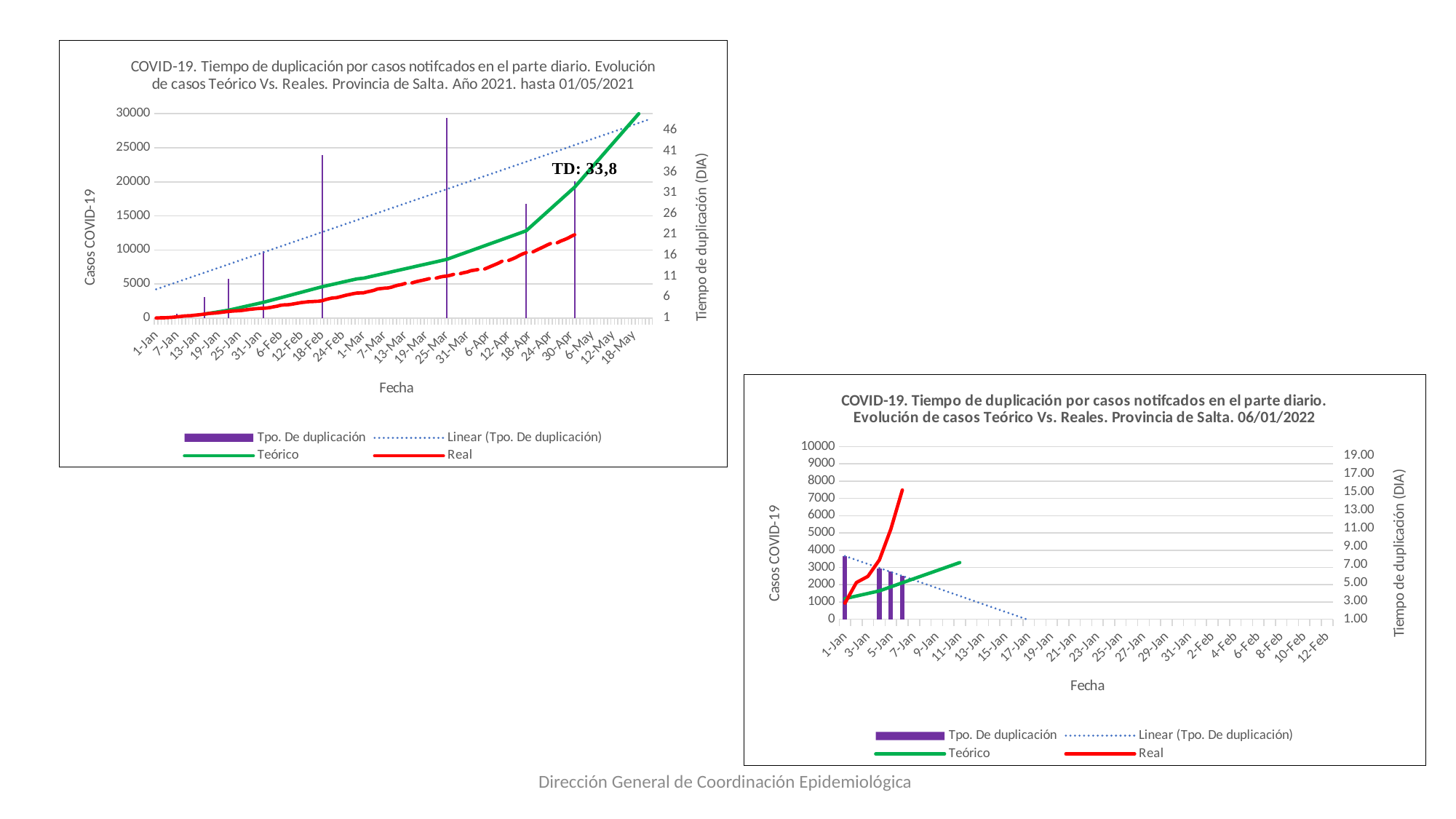
On the left chart (Año 2021, hasta 01/05/2021), on which date is the tallest Tpo. De duplicación bar? 25-Mar On the left chart (Año 2021, hasta 01/05/2021), is the Real value at 30-Apr greater or less than 15000? less On the left chart (Año 2021, hasta 01/05/2021), what kind of chart is it? Combined bar and line chart On the right chart (06/01/2022), which line is higher at 7-Jan, Real or Teórico? Real On the right chart (06/01/2022), does the dotted Linear (Tpo. De duplicación) line rise or fall along the x axis? falls On the right chart (06/01/2022), how many series does the legend list? 4 On the left chart (Año 2021, hasta 01/05/2021), how many series does the legend list? 4 On the left chart (Año 2021, hasta 01/05/2021), does the Teórico line rise or fall along the x axis? rises On the right chart (06/01/2022), is the Real value at 7-Jan greater or less than 5000? greater On the left chart (Año 2021, hasta 01/05/2021), is the Teórico value at 18-May greater or less than 25000? greater On the left chart (Año 2021, hasta 01/05/2021), what TD value is annotated on the chart? TD: 33,8 On the left chart (Año 2021, hasta 01/05/2021), which line is higher at 30-Apr, Teórico or Real? Teórico